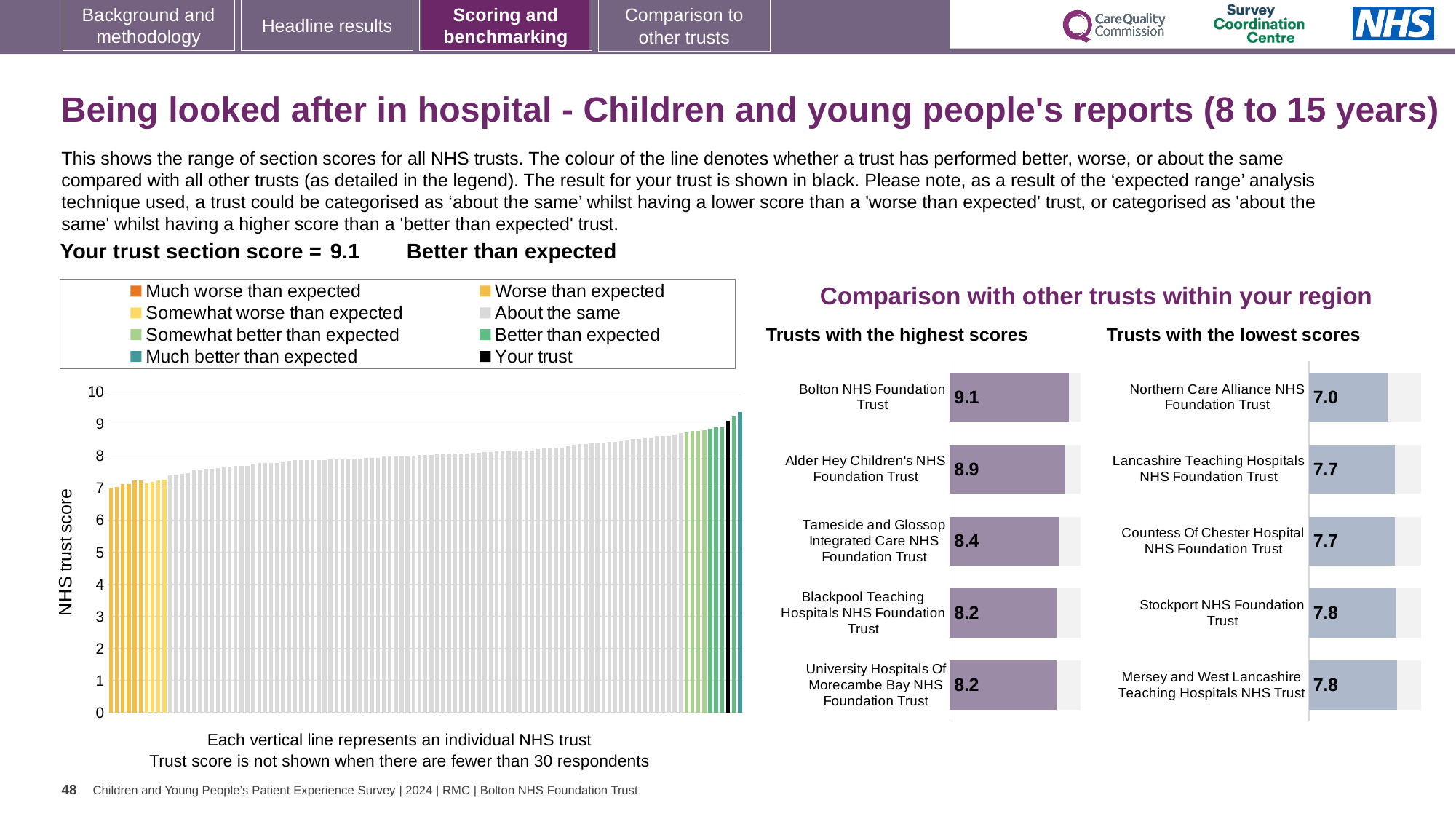
What kind of chart is the 'NHS trust score' chart on the left of the slide? Bar chart In the 'Trusts with the lowest scores' chart, what is the difference between the scores of Stockport NHS Foundation Trust and Northern Care Alliance NHS Foundation Trust? 0.8 In the 'Trusts with the highest scores' chart, which trust has the highest score? Bolton NHS Foundation Trust How many entries does the legend above the 'NHS trust score' chart list? 8 In the 'Trusts with the highest scores' chart, what is the score for Bolton NHS Foundation Trust? 9.1 In the 'Trusts with the highest scores' chart, how many trusts are listed? 5 In the 'Trusts with the highest scores' chart, what is the difference between the scores of Bolton NHS Foundation Trust and Alder Hey Children's NHS Foundation Trust? 0.2 In the 'NHS trust score' chart on the left, is the value of the leftmost bar greater or less than 8? less In the 'Trusts with the highest scores' chart, which has the larger score: Tameside and Glossop Integrated Care NHS Foundation Trust or Blackpool Teaching Hospitals NHS Foundation Trust? Tameside and Glossop Integrated Care NHS Foundation Trust In the 'Trusts with the lowest scores' chart, what is the score for Countess Of Chester Hospital NHS Foundation Trust? 7.7 In the 'NHS trust score' chart on the left, do the bars rise or fall from left to right? Rise In the 'Trusts with the lowest scores' chart, which trust has the lowest score? Northern Care Alliance NHS Foundation Trust